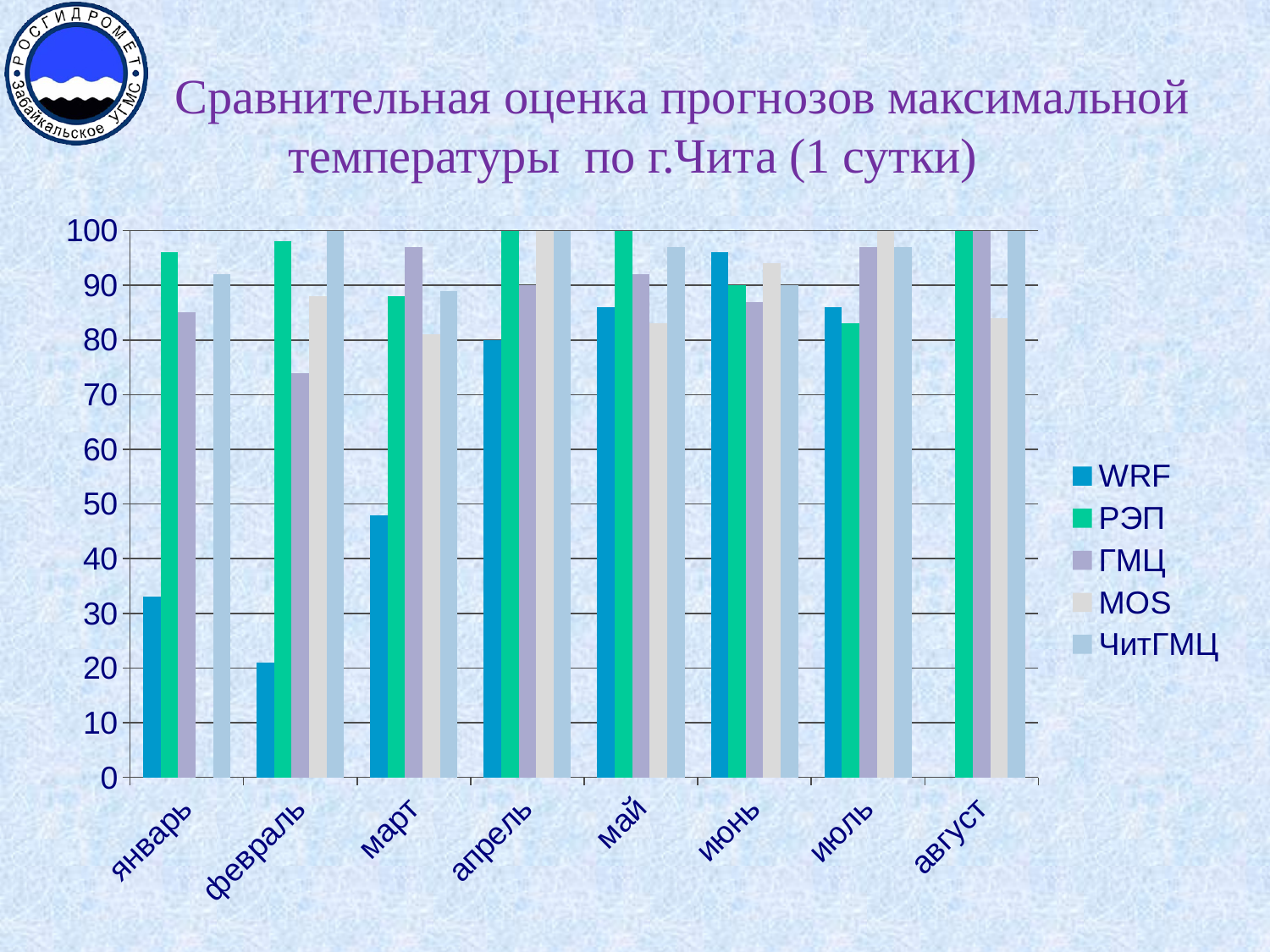
How many series does the legend list? 5 Which series has the highest value in январь? РЭП What is the value for ЧитГМЦ in февраль? 100 What kind of chart is shown on the slide? bar chart In март, which is larger: the value for WRF or the value for РЭП? РЭП How many months are shown on the x axis of the chart? 8 What is the value for РЭП in апрель? 100 Is the value for WRF in январь greater or less than 40? less Which series is shown in green in the legend? РЭП Which series has the lowest value in февраль? WRF Is the value for ГМЦ in февраль greater or less than 70? greater Is the value for WRF in февраль greater or less than 30? less